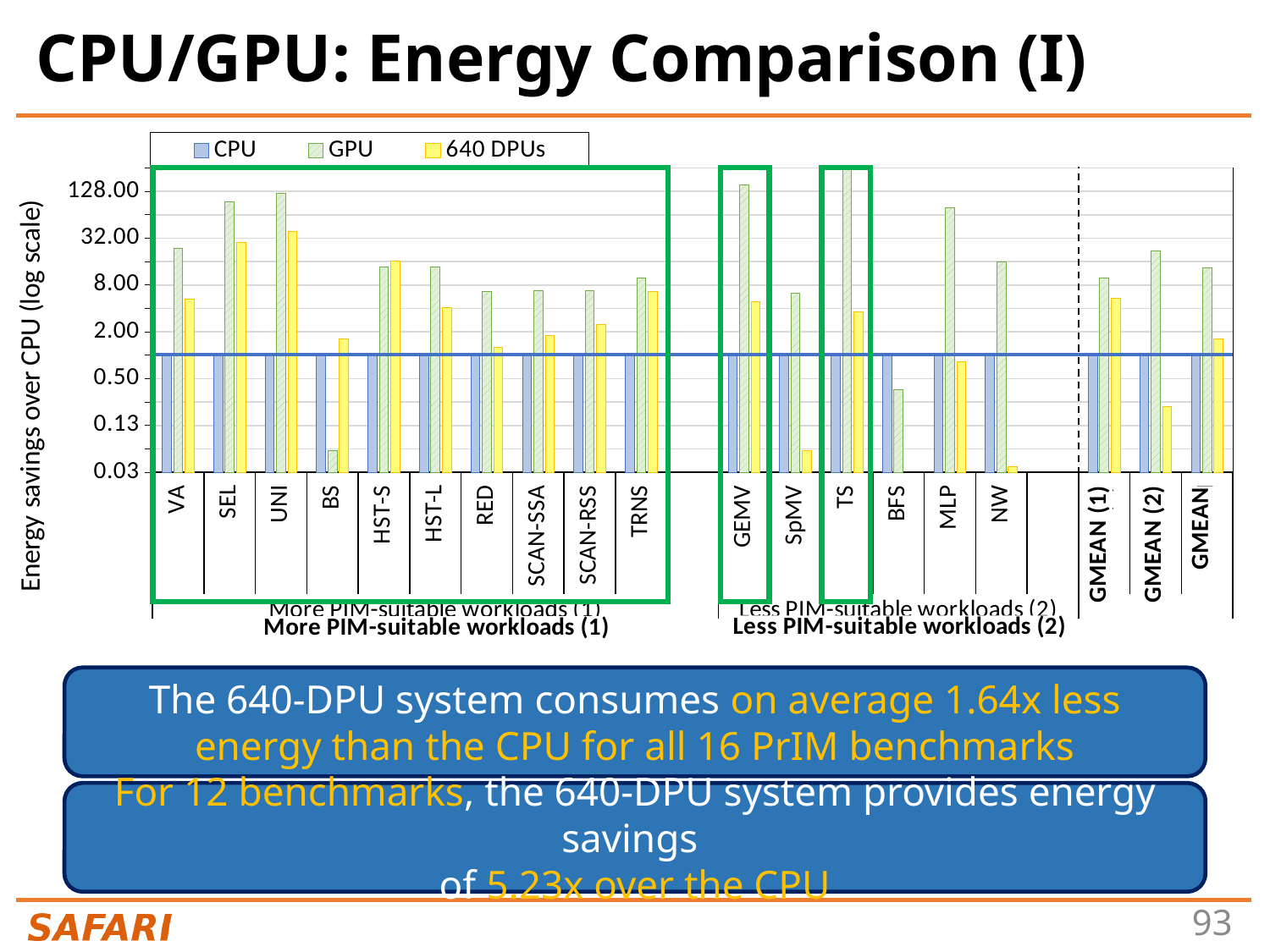
What are the three series named in the chart legend? CPU, GPU, 640 DPUs For BS, which is larger: the GPU value or the 640 DPUs value? 640 DPUs Is the 640 DPUs value for NW greater or less than 0.13? less Is the GPU value for SEL greater or less than 32.00? greater Which category has the lowest GPU value? BS For VA, which is larger: the GPU value or the 640 DPUs value? GPU How many series does the chart legend list? 3 Is the 640 DPUs value for GMEAN (1) greater or less than 2.00? greater What is the label of the y axis of the chart? Energy savings over CPU (log scale) What kind of chart is shown on the slide? bar chart How many categories are shown along the x axis of the chart? 19